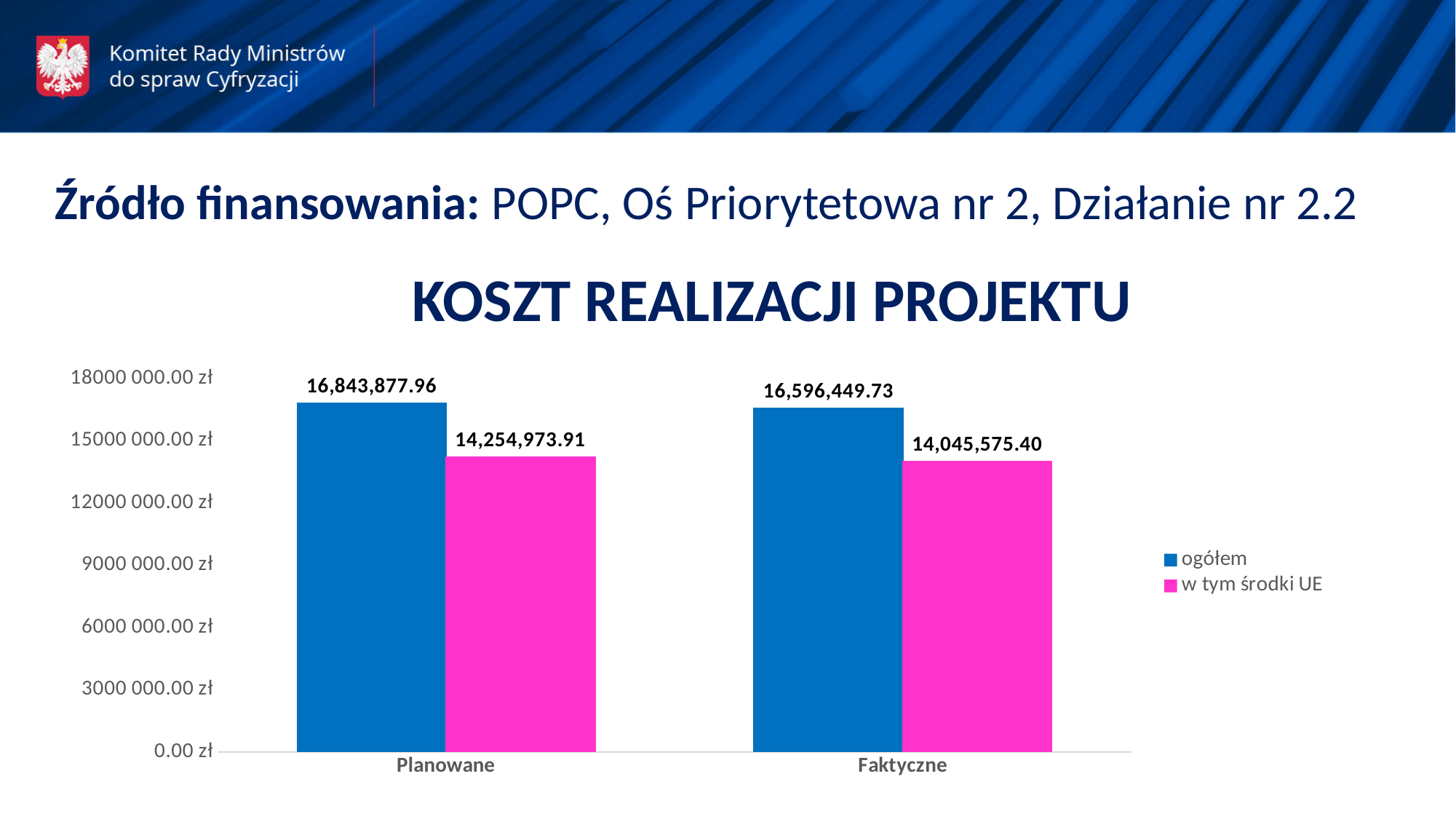
What kind of chart is shown on the slide? bar chart What is the value of the w tym środki UE bar for Faktyczne? 14,045,575.40 How many series does the legend list? 2 What is the value of the w tym środki UE bar for Planowane? 14,254,973.91 Which bar has the lowest value in the chart? w tym środki UE for Faktyczne Which is larger, the w tym środki UE value for Planowane or for Faktyczne? Planowane Is the ogółem value for Faktyczne greater or less than 15000 000.00 zł? greater What is the difference between the ogółem and w tym środki UE values for Planowane? 2,588,904.05 What is the value of the ogółem bar for Planowane? 16,843,877.96 What is the difference between the ogółem values for Planowane and Faktyczne? 247,428.23 What is the value of the ogółem bar for Faktyczne? 16,596,449.73 Which bar has the highest value in the chart? ogółem for Planowane